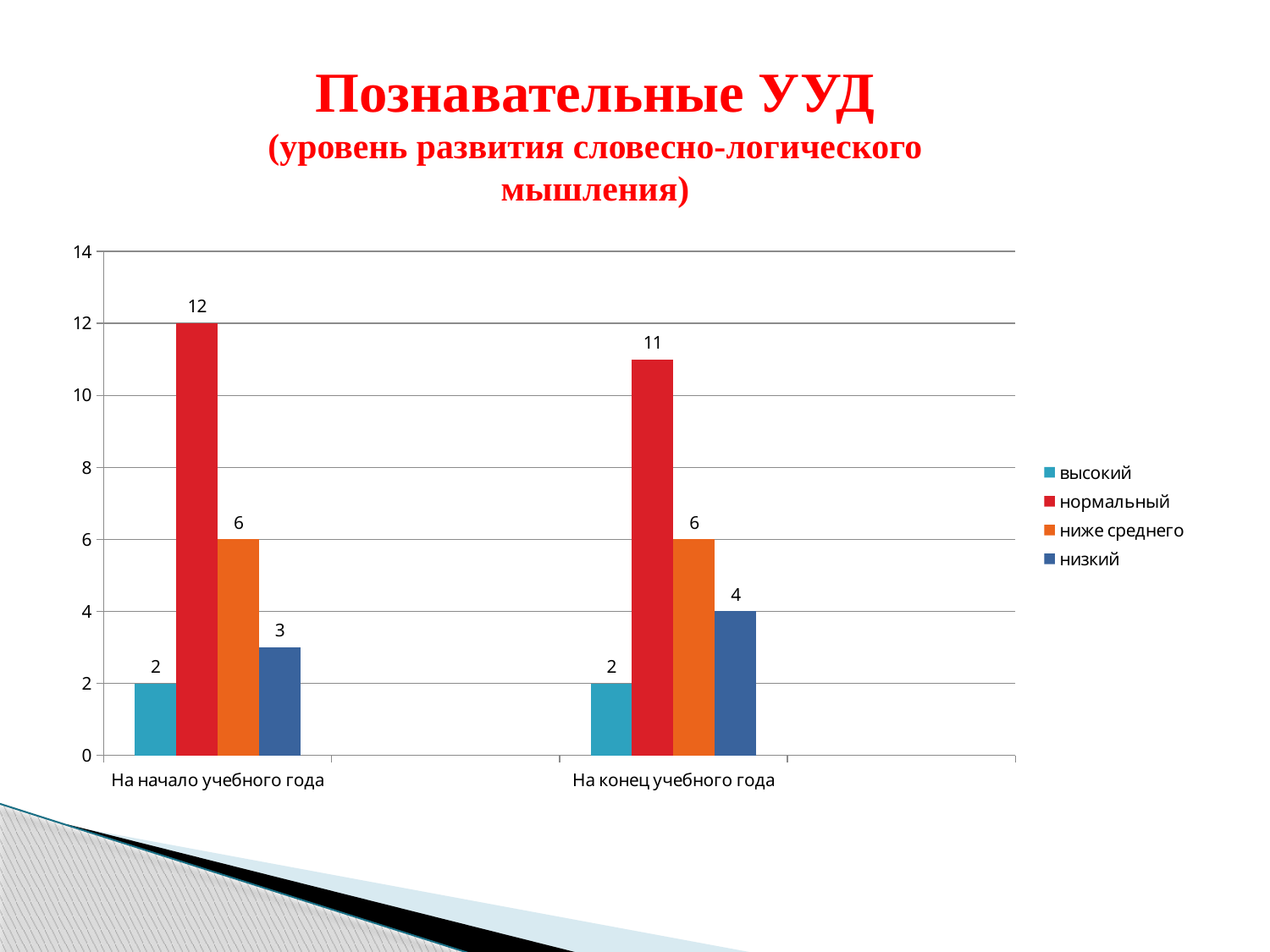
What is the value for "ниже среднего" at "На начало учебного года"? 6 What is the difference between the "нормальный" values at "На начало учебного года" and "На конец учебного года"? 1 How many series does the legend list? 4 What is the value for "нормальный" at "На начало учебного года"? 12 What is the value for "низкий" at "На конец учебного года"? 4 What kind of chart is shown on the slide? bar chart What colour are the bars for the "ниже среднего" series? orange What is the value for "высокий" at "На конец учебного года"? 2 How many categories are shown on the x axis? 2 Which series has the lowest value at "На конец учебного года"? высокий Which is larger: "низкий" at "На начало учебного года" or "низкий" at "На конец учебного года"? На конец учебного года Which series has the highest value at "На начало учебного года"? нормальный